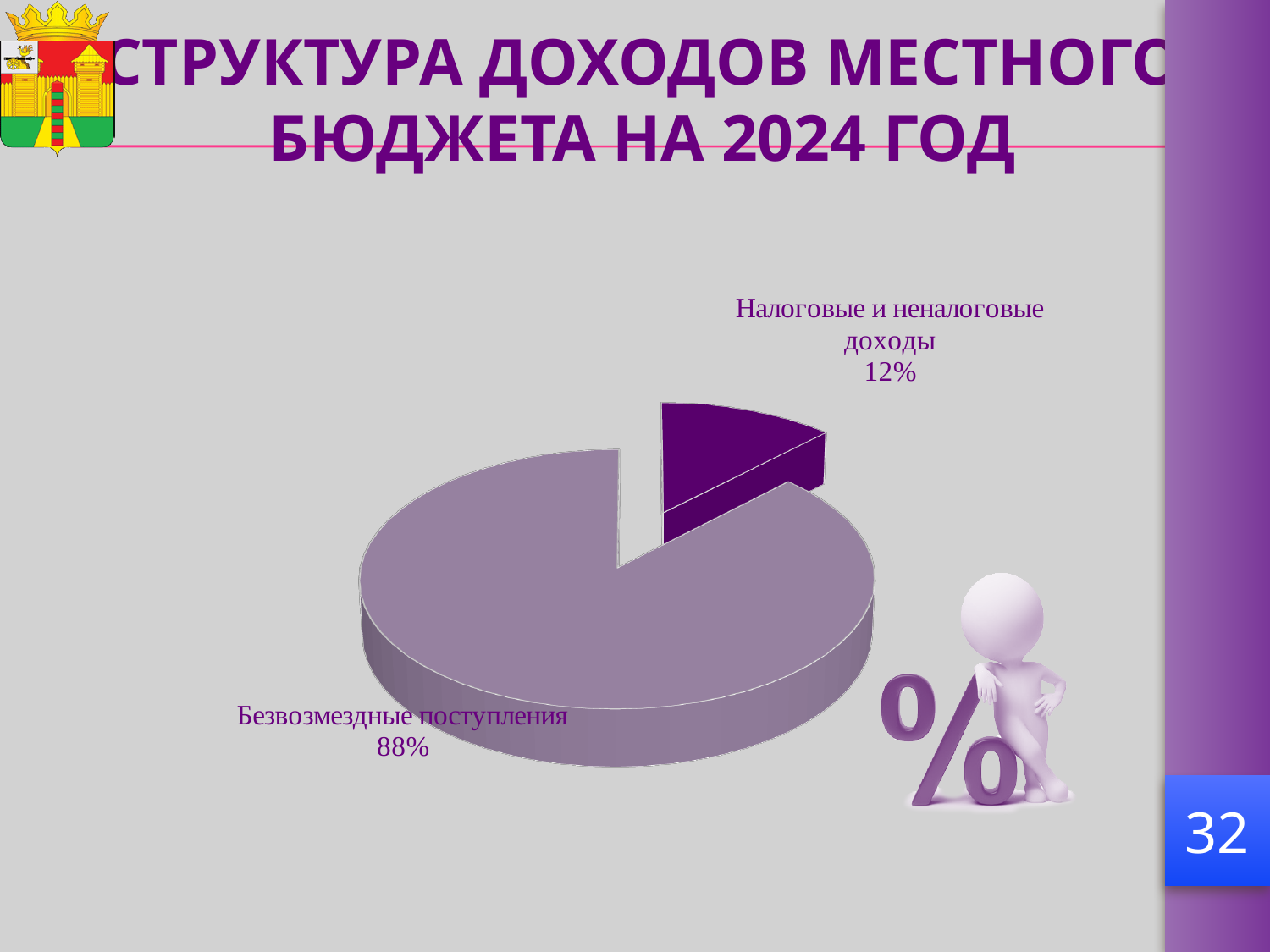
Which is larger: the share of 'Безвозмездные поступления' or the share of 'Налоговые и неналоговые доходы'? Безвозмездные поступления How many slices does the pie chart have? 2 What is the total of the two slice percentages shown on the pie? 100% What share of the pie does 'Безвозмездные поступления' have? 88% Which slice is pulled out (exploded) from the pie? Налоговые и неналоговые доходы What share of the pie does 'Налоговые и неналоговые доходы' have? 12% What kind of chart is shown on the slide? pie chart Which category has the smallest share of the pie? Налоговые и неналоговые доходы What is the title of the slide containing the chart? СТРУКТУРА ДОХОДОВ МЕСТНОГО БЮДЖЕТА НА 2024 ГОД Which category has the largest share of the pie? Безвозмездные поступления What is the difference in percentage points between 'Безвозмездные поступления' and 'Налоговые и неналоговые доходы'? 76